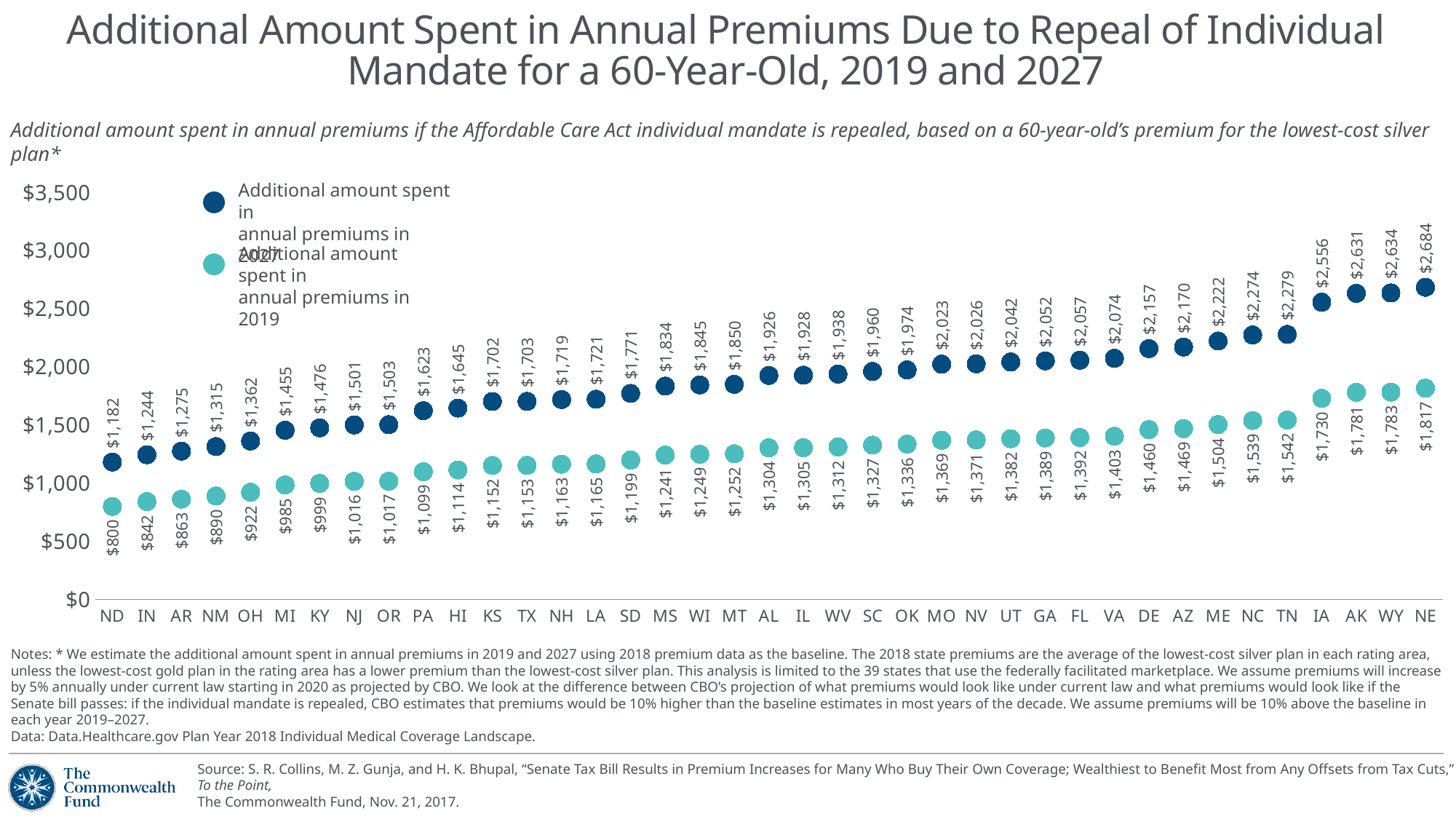
How many series does the legend list? 2 For NE, how much larger is the 2027 additional amount than the 2019 additional amount? $867 What is the additional amount spent in annual premiums in 2019 for ND? $800 Do the 2027 values rise or fall moving from ND on the left to NE on the right? Rise Which state has the highest additional amount spent in annual premiums in 2027? NE What is the additional amount spent in annual premiums in 2027 for TX? $1,703 What is the difference between the 2027 additional amount for AK and the 2027 additional amount for IN? $1,387 Is the 2019 additional amount for IA greater or less than $1,500? greater Which state has the lowest additional amount spent in annual premiums in 2019? ND How many states are shown on the x axis? 39 Which is larger: the 2027 additional amount for ND or the 2019 additional amount for NE? The 2019 additional amount for NE What is the additional amount spent in annual premiums in 2019 for FL? $1,392